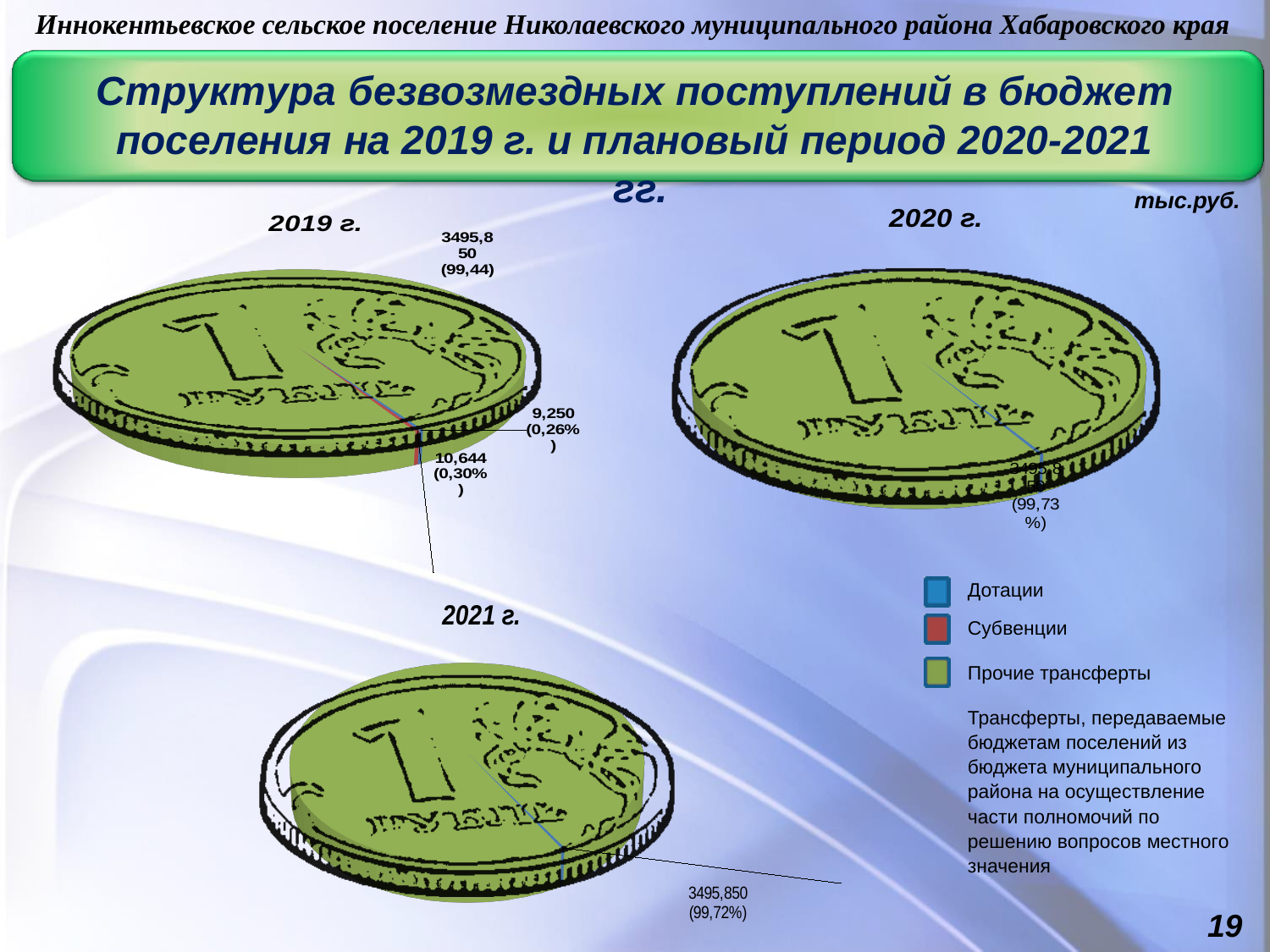
In what units are the chart values given, according to the slide? тыс.руб. How many pie charts are shown on the slide? 3 In the 2019 г. chart, which of the two small slices is larger: the one labelled 9,250 or the one labelled 10,644? 10,644 In the 2020 г. chart, what share is printed for the largest slice? 99,73% In the 2019 г. chart, what is the difference between the slices labelled 10,644 and 9,250? 1,394 Which legend entry is shown in green? Прочие трансферты In the 2019 г. chart, what share is printed for the slice labelled 10,644? 0,30% In the 2021 г. chart, what share is printed for the largest slice? 99,72% How many entries does the legend list? 3 In the 2019 г. chart, what value is printed for the largest slice? 3495,850 (99,44) In the 2021 г. chart, what value is printed for the largest slice? 3495,850 What type of chart is used to show the structure of gratuitous receipts for each year on this slide? pie chart